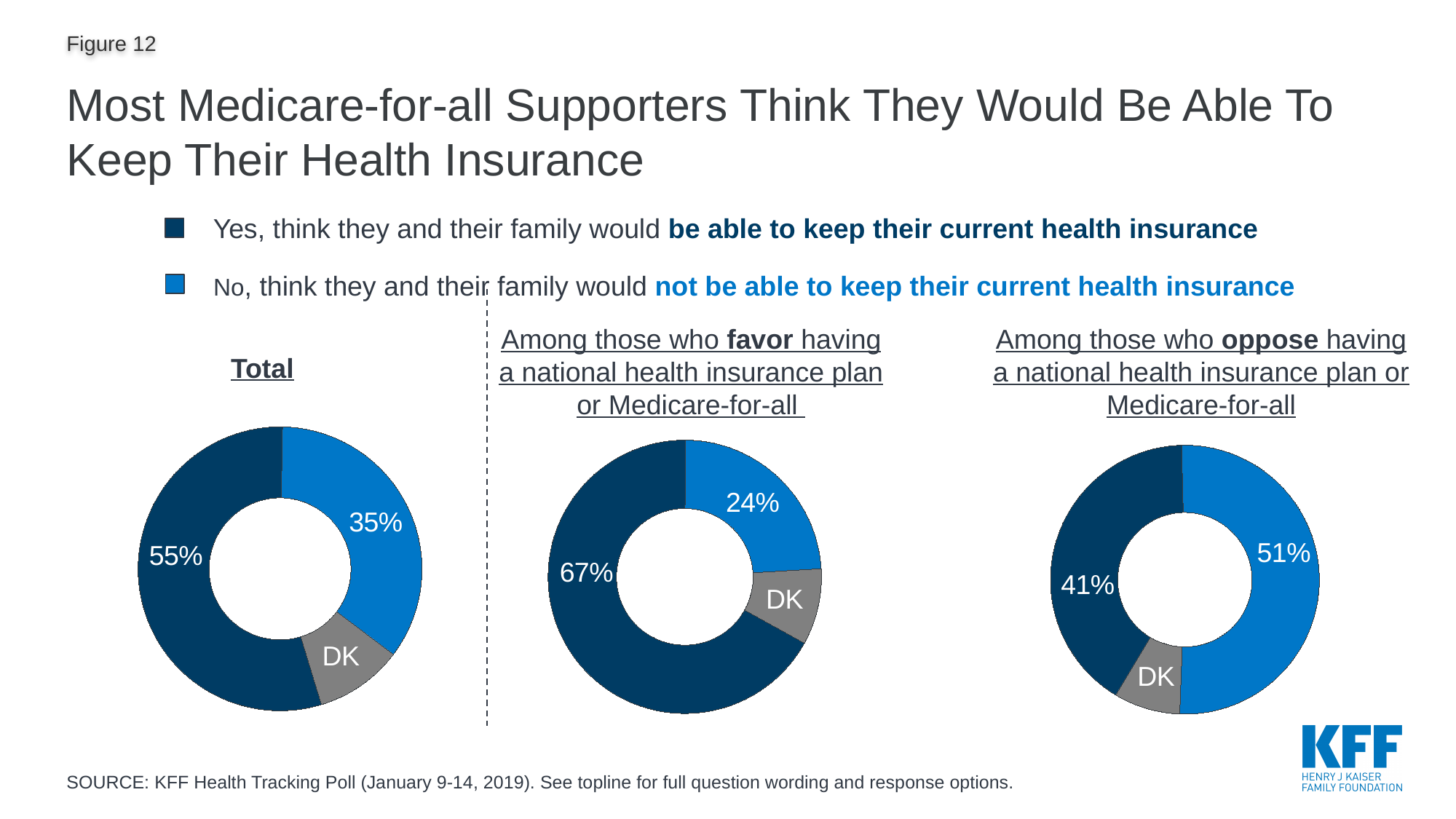
How many donut charts are shown on the slide? 3 What is the difference between the 'able to keep' share among those who favor Medicare-for-all and among those who oppose it? 26 percentage points What kind of chart is used on this slide? Donut (pie) chart In the Total chart, what share think they would be able to keep their current health insurance? 55% In the chart for those who favor Medicare-for-all, which is larger: the share who think they would be able to keep their insurance or the share who think they would not? Able to keep their current health insurance In the chart for those who favor a national health insurance plan or Medicare-for-all, what share think they would not be able to keep their current health insurance? 24% In the Total chart, what share think they would not be able to keep their current health insurance? 35% In the chart for those who oppose a national health insurance plan or Medicare-for-all, what share think they would not be able to keep their current health insurance? 51% In the chart for those who favor a national health insurance plan or Medicare-for-all, what share think they would be able to keep their current health insurance? 67% In the chart for those who oppose Medicare-for-all, which is larger: the share who think they would be able to keep their insurance or the share who think they would not? Not be able to keep their current health insurance In the Total chart, what is the difference between the share who think they would be able to keep their insurance and the share who think they would not? 20 percentage points In the chart for those who oppose a national health insurance plan or Medicare-for-all, what share think they would be able to keep their current health insurance? 41%